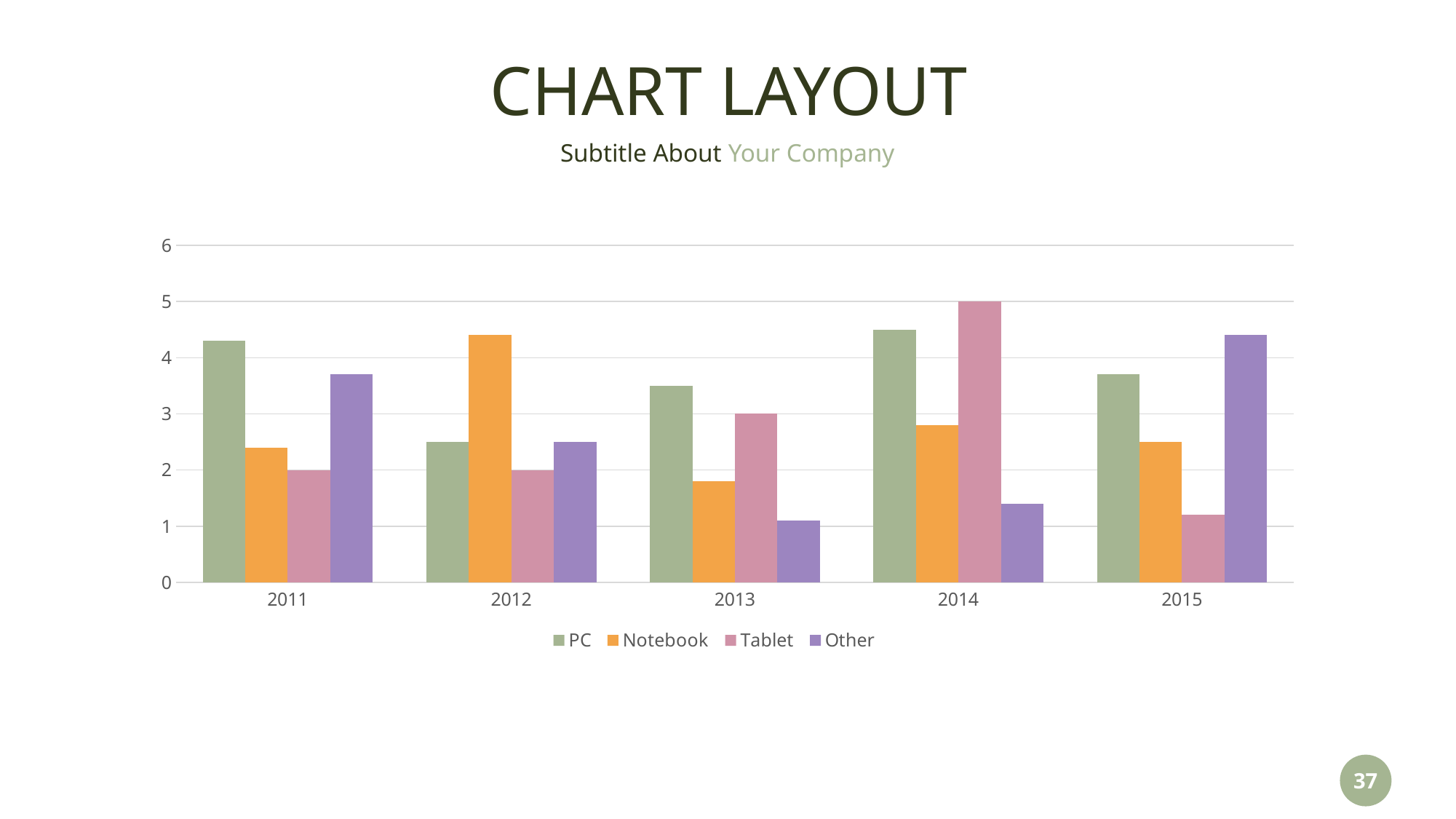
What is the value for Tablet in 2013? 3 Is the value for Notebook in 2013 greater or less than 2? less What kind of chart is shown on the slide? bar chart Is the value for PC in 2011 greater or less than 4? greater Which is larger in 2014, PC or Notebook? PC Does the Tablet series rise or fall from 2012 to 2014? rise Which series has the highest bar in 2012? Notebook What is the value for Tablet in 2011? 2 How many series does the chart legend list? 4 What is the value for Tablet in 2014? 5 How many years are shown on the x axis of the chart? 5 Which series has the lowest bar in 2014? Other